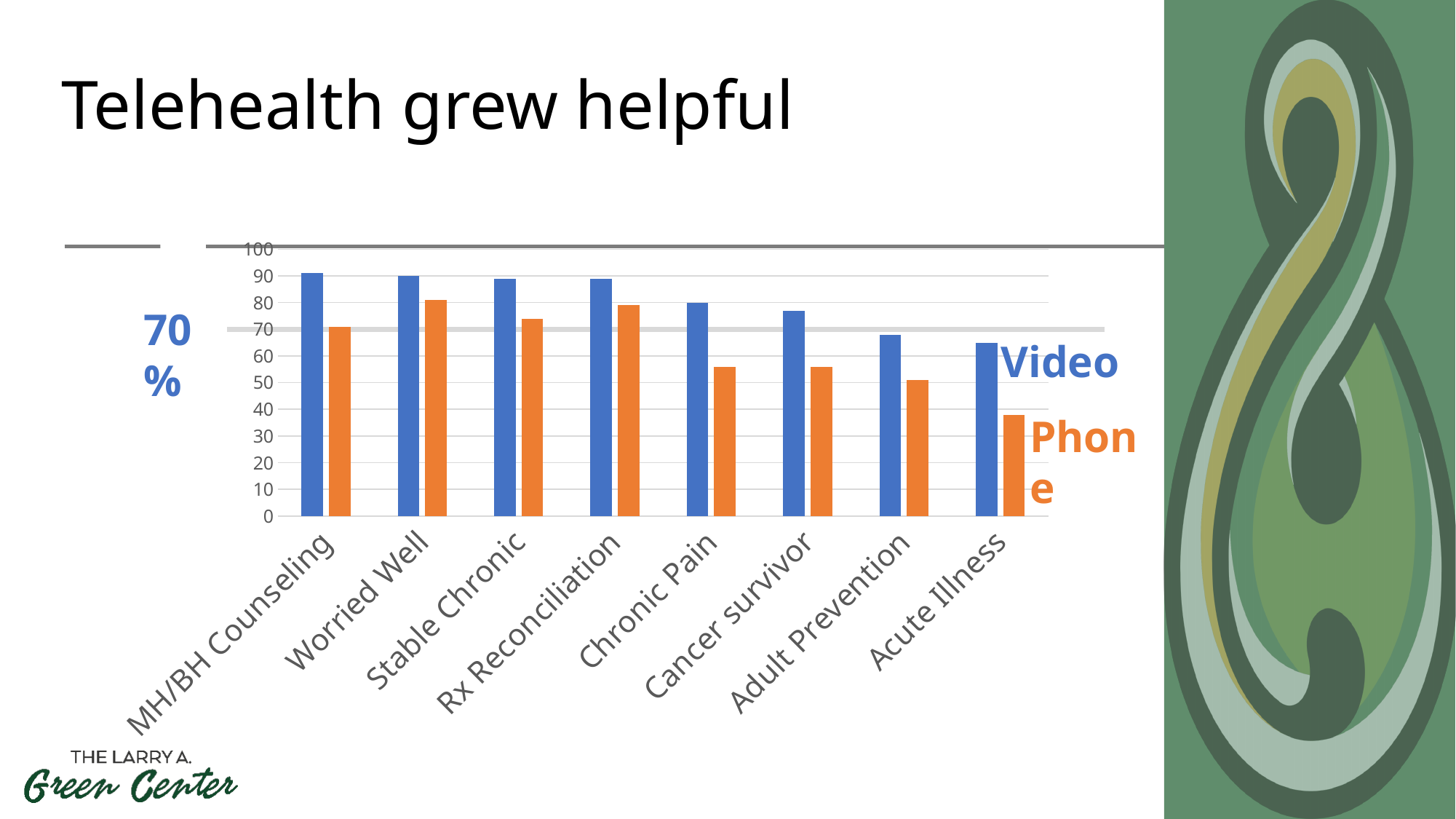
How many categories are shown on the x axis of the chart? 8 How many series does the chart show? 2 Which series is shown in orange? Phone Is the Phone value for Acute Illness greater or less than 50? less Is the Phone value for Worried Well greater or less than 70? greater What kind of chart is shown on the slide? bar chart Which has the larger Phone value: Worried Well or Chronic Pain? Worried Well Which category has the lowest Phone value? Acute Illness For Acute Illness, which is larger: the Video value or the Phone value? Video Is the Phone value for Chronic Pain greater or less than 60? less Do the Video values generally rise or fall moving from left to right along the x axis? fall